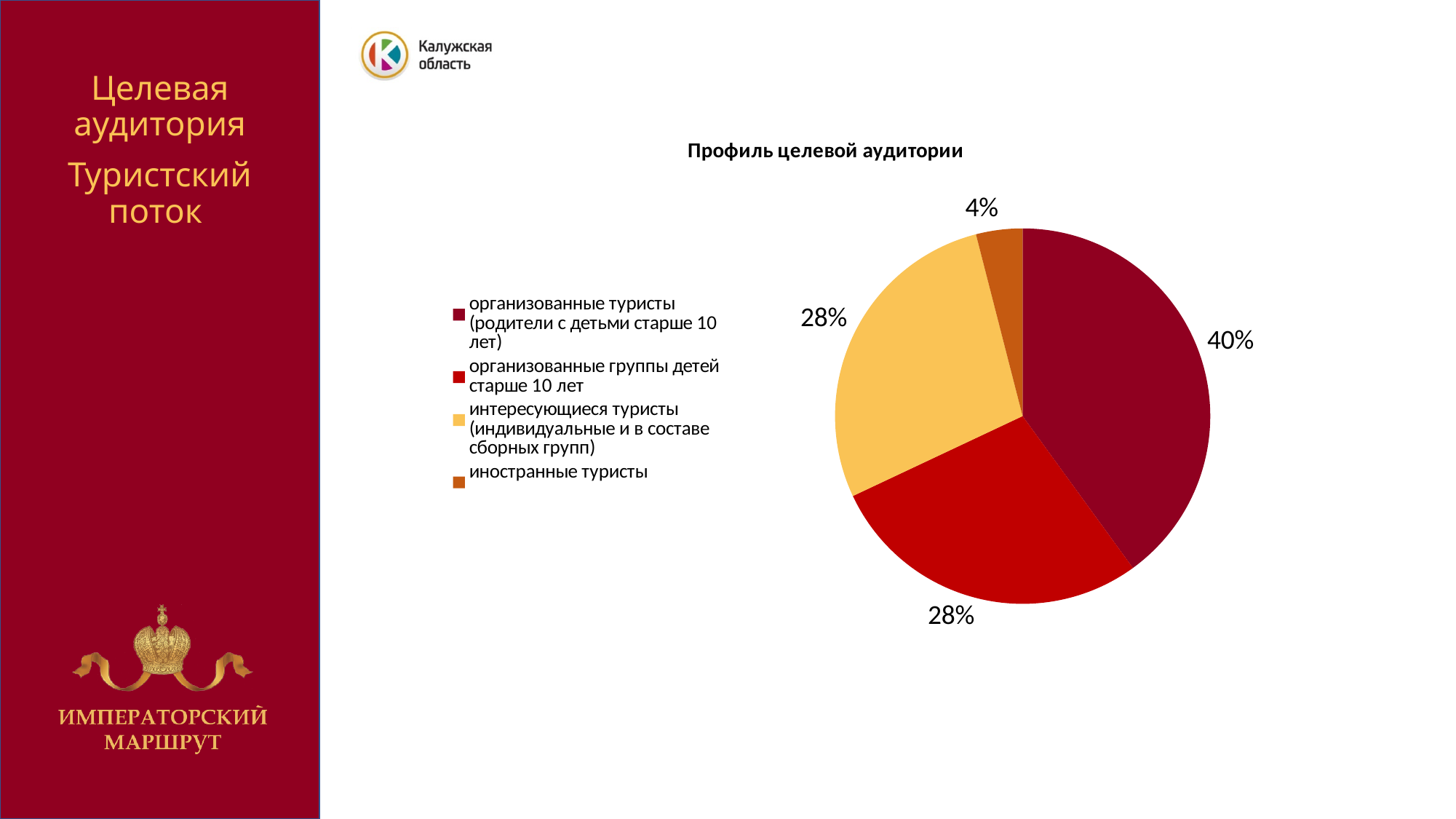
What share of the pie is taken by организованные туристы (родители с детьми старше 10 лет)? 40% Which category has the largest slice of the pie? организованные туристы (родители с детьми старше 10 лет) What share of the pie is taken by иностранные туристы? 4% What kind of chart is shown on the slide? pie chart What colour is the slice for иностранные туристы? orange How many categories does the pie chart show? 4 Which category has the smallest slice of the pie? иностранные туристы What is the difference in percentage points between организованные туристы (родители с детьми старше 10 лет) and иностранные туристы? 36% What share of the pie is taken by организованные группы детей старше 10 лет? 28% What is the title of the chart? Профиль целевой аудитории Which is larger: the share for организованные группы детей старше 10 лет or the share for иностранные туристы? организованные группы детей старше 10 лет